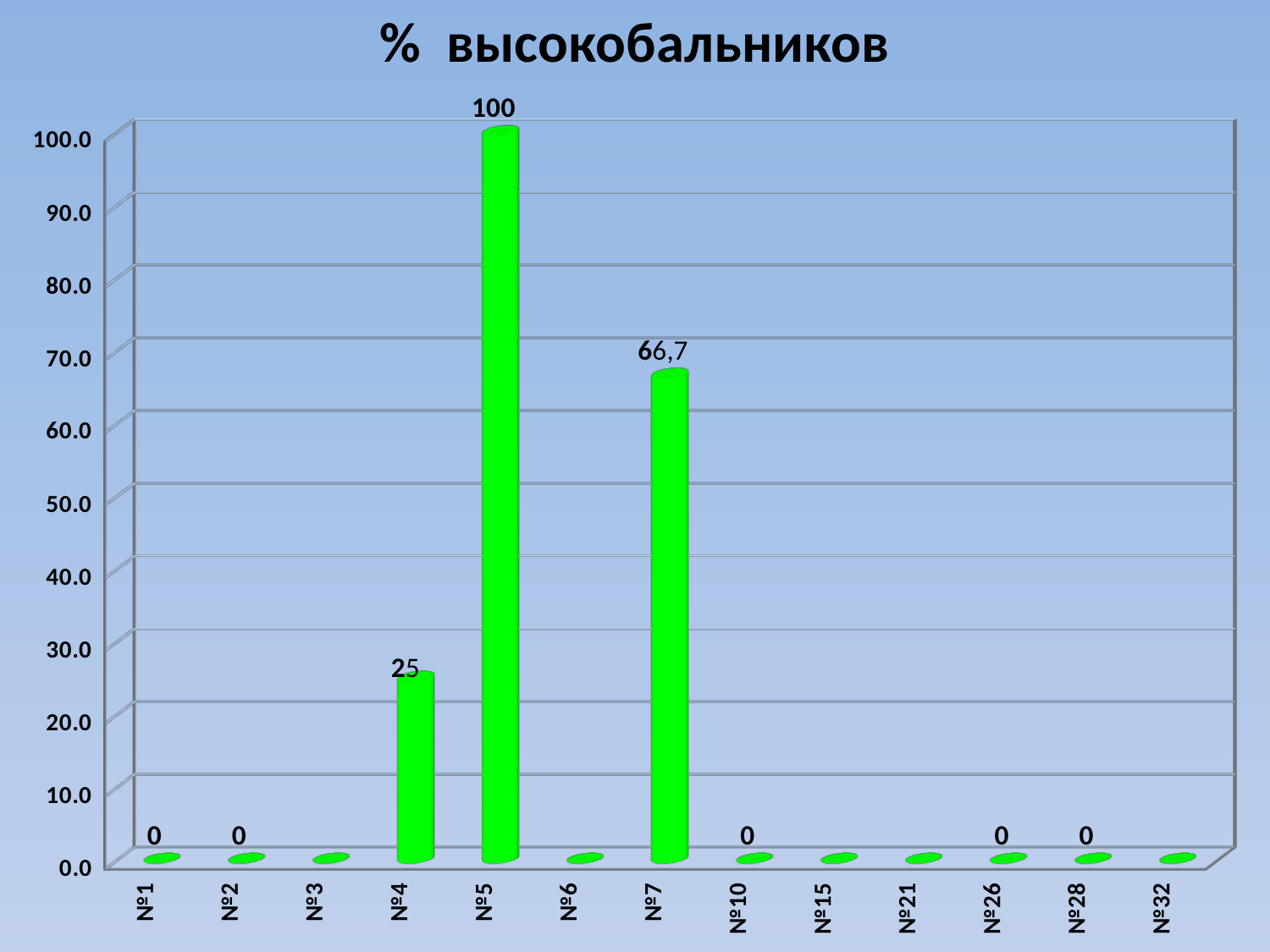
What is the value for №7? 66,7 Is the value for №7 greater or less than 60.0? greater What is the value for №5? 100 Which category has the highest value? №5 What is the value for №26? 0 What type of chart is shown on the slide? bar chart How many categories are shown on the x axis? 13 Which is larger, the value for №4 or the value for №7? №7 What is the difference between the values for №5 and №4? 75 What is the title of the chart? % высокобальников What is the difference between the values for №5 and №7? 33,3 What is the value for №4? 25